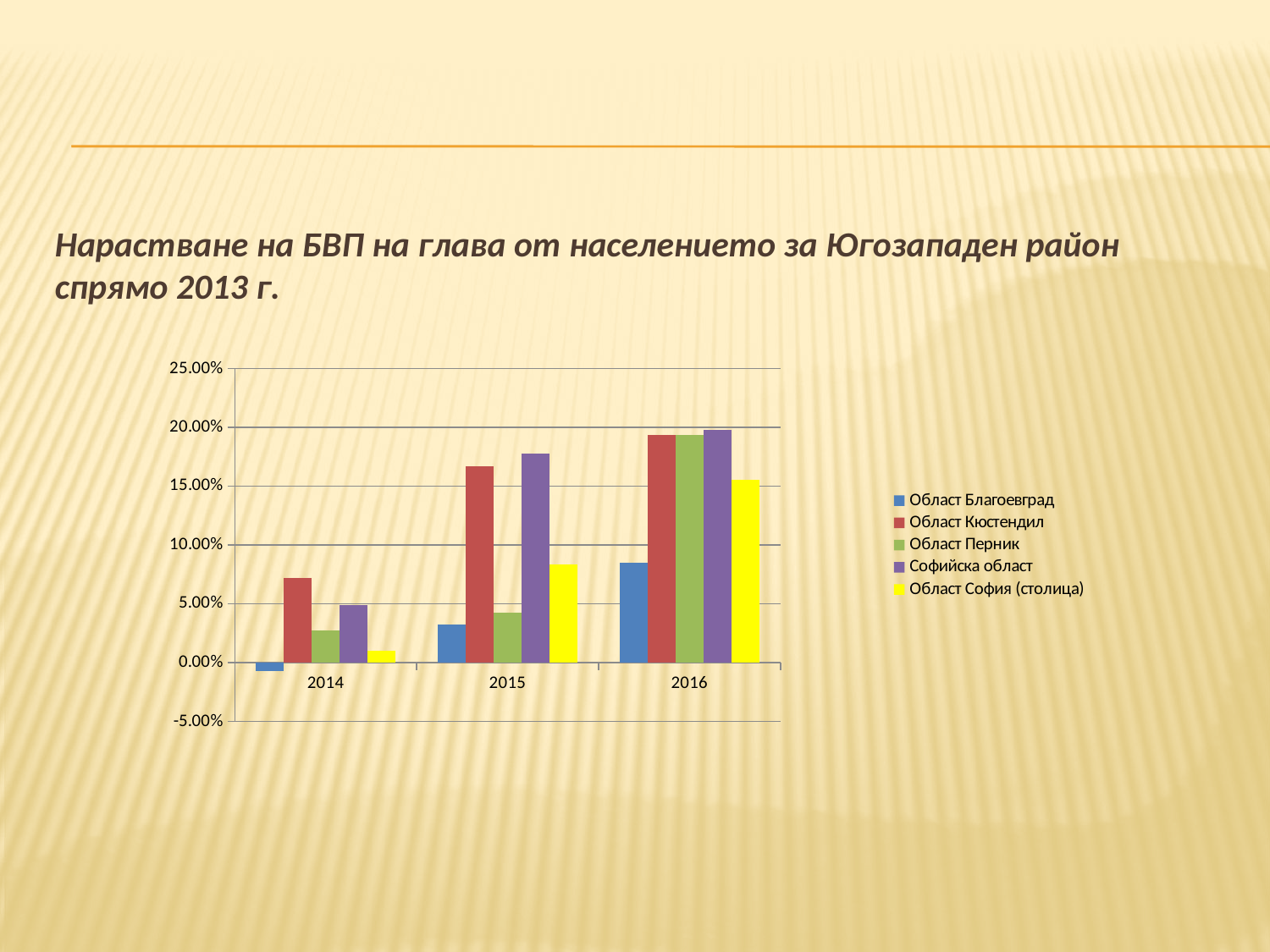
In 2015, which is larger: the value for Софийска област or the value for Област Перник? Софийска област Is the value for Област София (столица) in 2016 greater or less than 20.00%? less How many years (categories) are shown on the x axis? 3 Which series is shown in yellow in the legend? Област София (столица) Is the value for Област Благоевград in 2014 greater or less than 0.00%? less Do the values for Област Благоевград rise or fall from 2014 to 2016? Rise Which region has the lowest value in 2016? Област Благоевград Which region has the lowest value in 2014? Област Благоевград Which region has the highest value in 2014? Област Кюстендил How many series does the legend list? 5 What kind of chart is shown on the slide? Bar chart Is the value for Област Кюстендил in 2015 greater or less than 15.00%? greater